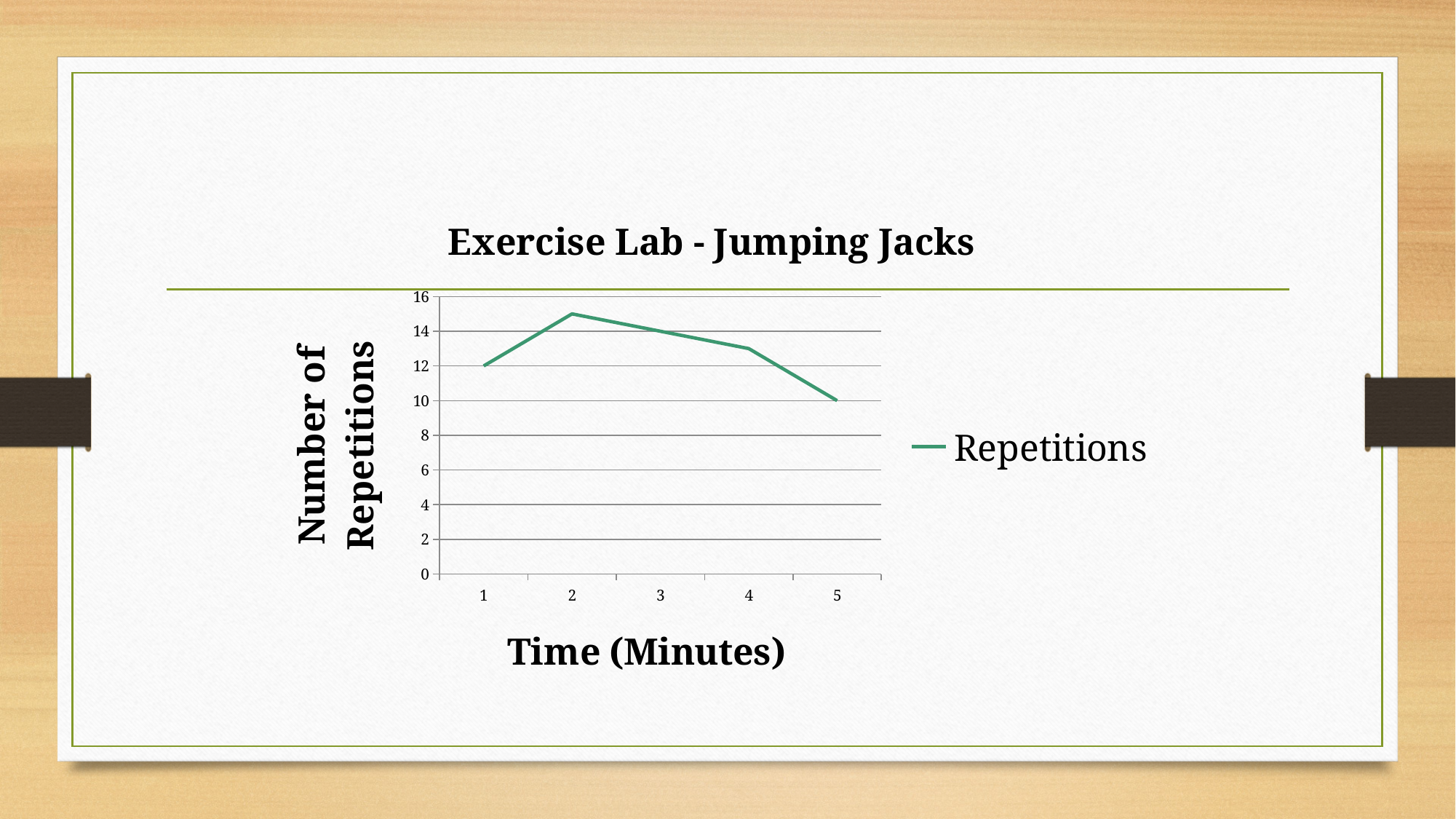
How many series does the legend list? 1 Is the number of repetitions at minute 2 greater or less than 14? greater Do the repetitions rise or fall from minute 2 to minute 5? fall What is the difference in repetitions between minute 1 and minute 5? 2 How many time points are plotted on the x axis? 5 What is the number of repetitions at minute 5? 10 What is the title of the chart? Exercise Lab - Jumping Jacks What type of chart is shown on the slide? line chart What is the number of repetitions at minute 3? 14 At which minute is the number of repetitions lowest? 5 At which minute is the number of repetitions highest? 2 What is the number of repetitions at minute 1? 12